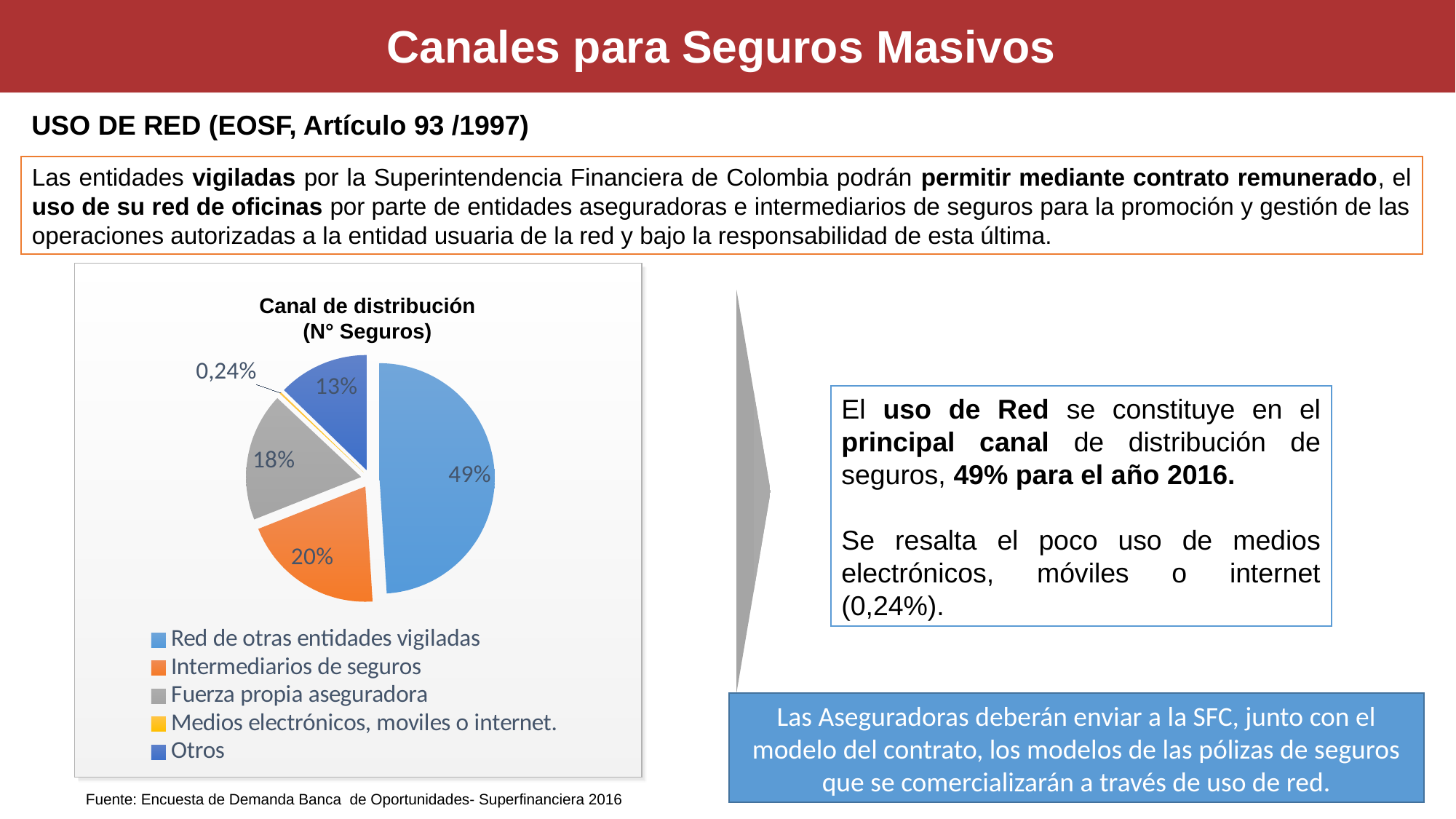
What is the title of the chart? Canal de distribución (N° Seguros) What is the difference in percentage points between 'Red de otras entidades vigiladas' and 'Fuerza propia aseguradora'? 31% Which category has the smallest slice of the pie? Medios electrónicos, moviles o internet. What share of the pie does 'Red de otras entidades vigiladas' have? 49% What share of the pie does 'Otros' have? 13% What type of chart is shown on the slide? pie chart What share of the pie does 'Fuerza propia aseguradora' have? 18% Which category has the largest slice of the pie? Red de otras entidades vigiladas How many categories does the pie chart show? 5 Which is larger, the slice for 'Intermediarios de seguros' or the slice for 'Otros'? Intermediarios de seguros What share of the pie does 'Medios electrónicos, moviles o internet.' have? 0,24% What share of the pie does 'Intermediarios de seguros' have? 20%